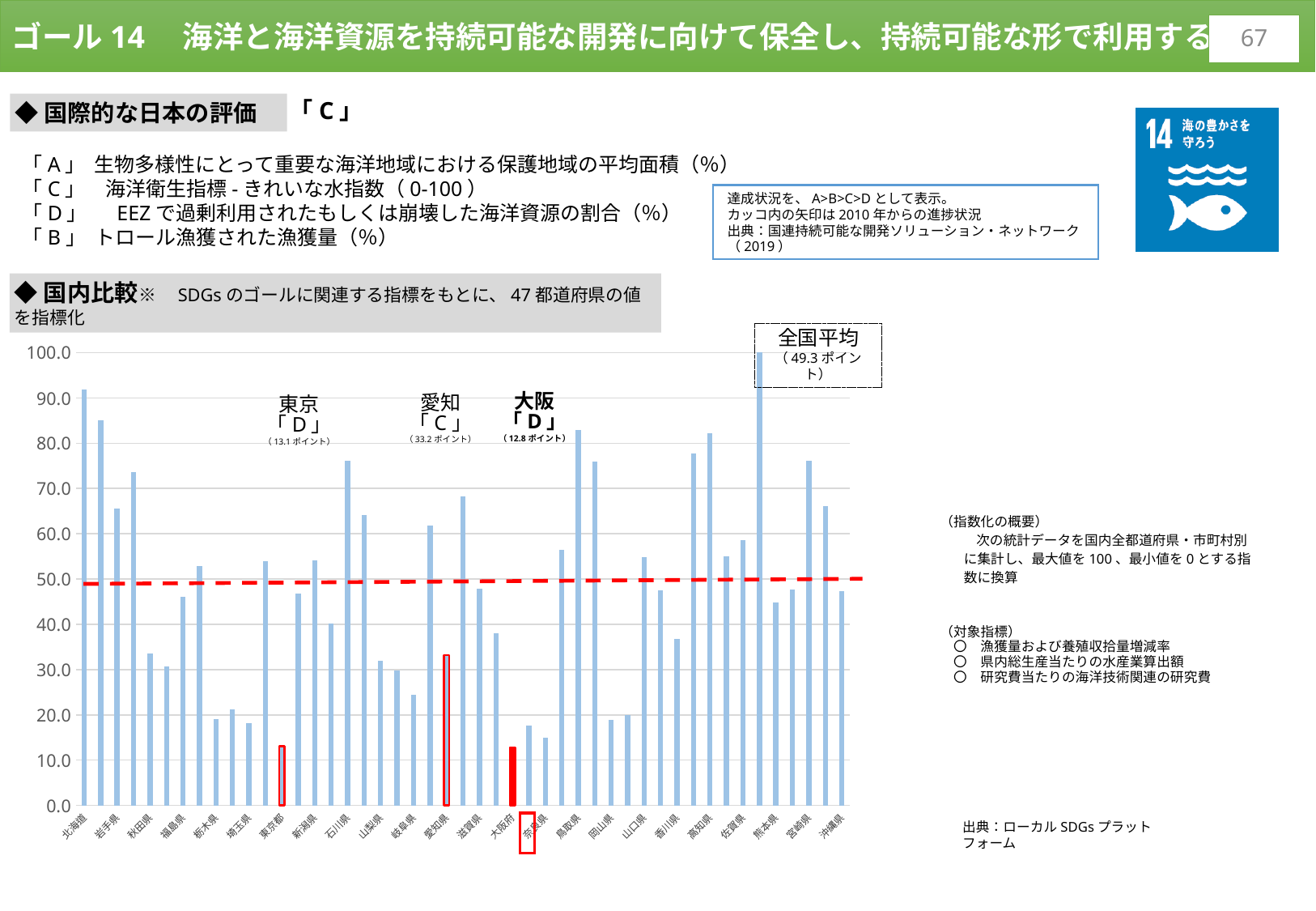
What is the 全国平均 value indicated on the bar chart? 49.3 ポイント What is the value shown for 大阪 in the bar chart? 12.8 ポイント How many prefectures are indexed in the bar chart according to the slide? 47 Is the value for 奈良県 in the bar chart greater or less than 20? less What does the red dashed horizontal line in the bar chart represent? 全国平均 What is the value shown for 愛知 in the bar chart? 33.2 ポイント Which prefecture has the lowest bar in the chart? 大阪府 Which has the larger value in the bar chart, 愛知 or 東京? 愛知 Is the value for 石川県 in the bar chart greater or less than 70? greater What is the difference between the values for 愛知 and 東京 in the bar chart? 20.1 ポイント What is the value shown for 東京 in the bar chart? 13.1 ポイント What kind of chart is used in the 国内比較 section of the slide? bar chart